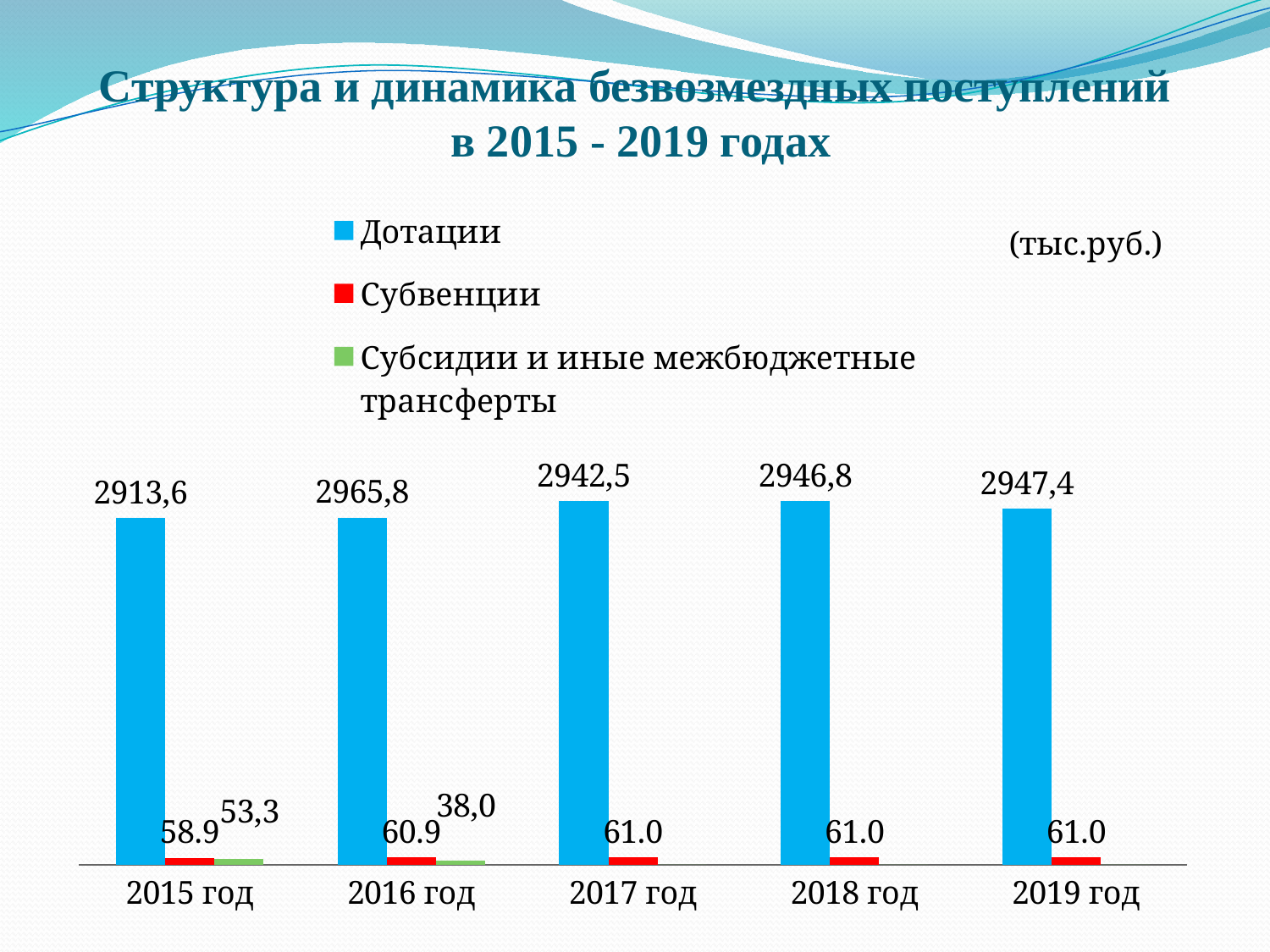
What is the value for Субвенции in 2015 год? 58.9 What unit is indicated for the values on the chart? тыс.руб. Which is larger: the Субвенции value for 2015 год or for 2016 год? 2016 год What is the value for Субсидии и иные межбюджетные трансферты in 2016 год? 38,0 How many years are shown on the x axis? 5 What kind of chart is shown on the slide? Bar chart What is the value for Дотации in 2016 год? 2965,8 What is the difference between the Дотации values for 2016 год and 2015 год? 52,2 How many series does the legend list? 3 In which year is the value for Дотации the lowest? 2015 год What is the value for Дотации in 2019 год? 2947,4